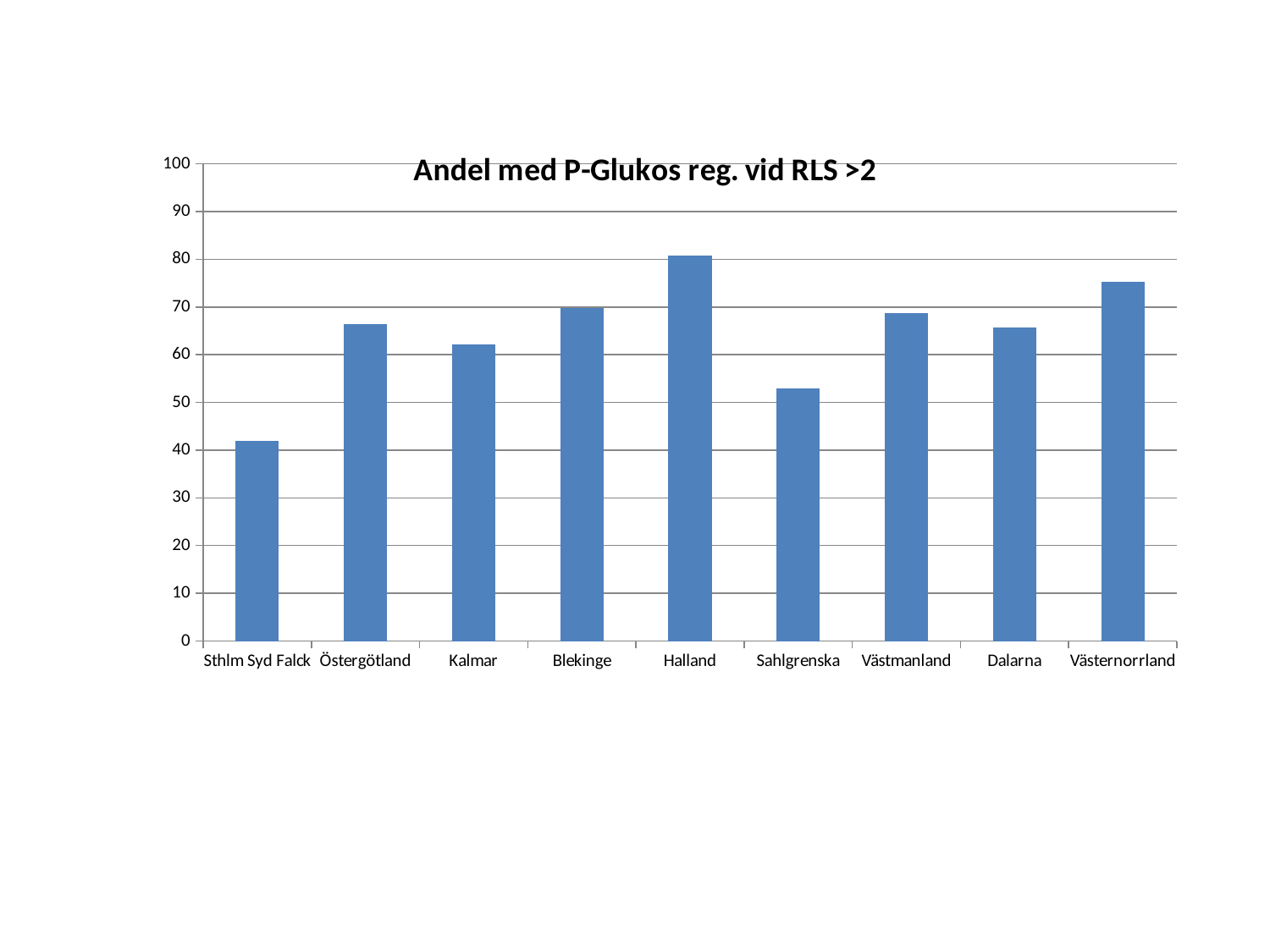
What is the title of the chart? Andel med P-Glukos reg. vid RLS >2 What kind of chart is shown on the slide? bar chart Is the value for Kalmar greater or less than 60? greater Is the value for Sthlm Syd Falck greater or less than 50? less How many categories are shown on the x axis? 9 Which has a larger value, Västernorrland or Dalarna? Västernorrland Is the value for Sahlgrenska greater or less than 60? less Which category has the lowest value? Sthlm Syd Falck Which has a larger value, Halland or Sahlgrenska? Halland Which has a larger value, Kalmar or Blekinge? Blekinge Which category has the highest value? Halland